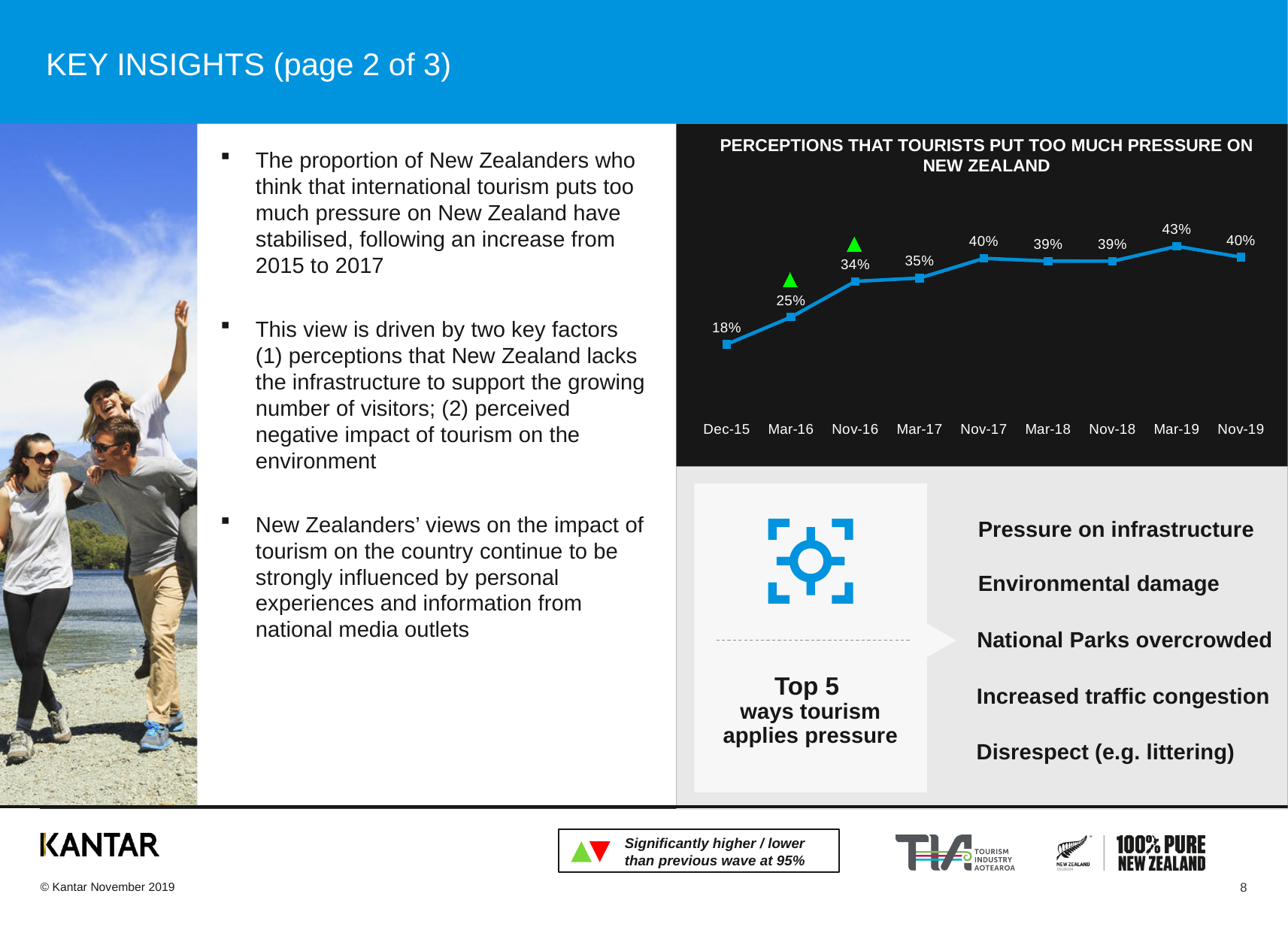
Which is larger, the value for Nov-17 or the value for Mar-17? Nov-17 What is the value for Nov-19 in the chart? 40% What is the difference between the values for Mar-19 and Dec-15? 25 percentage points What is the value for Mar-19 in the chart? 43% What is the difference between the values for Mar-16 and Dec-15? 7 percentage points How many time periods are plotted in the chart? 9 Which period has the highest value in the chart? Mar-19 What kind of chart is shown on the slide? Line chart What is the value for Nov-16 in the chart? 34% Do the values generally rise or fall from Dec-15 to Mar-19? Rise What is the value for Dec-15 in the chart 'Perceptions that tourists put too much pressure on New Zealand'? 18% Which period has the lowest value in the chart? Dec-15